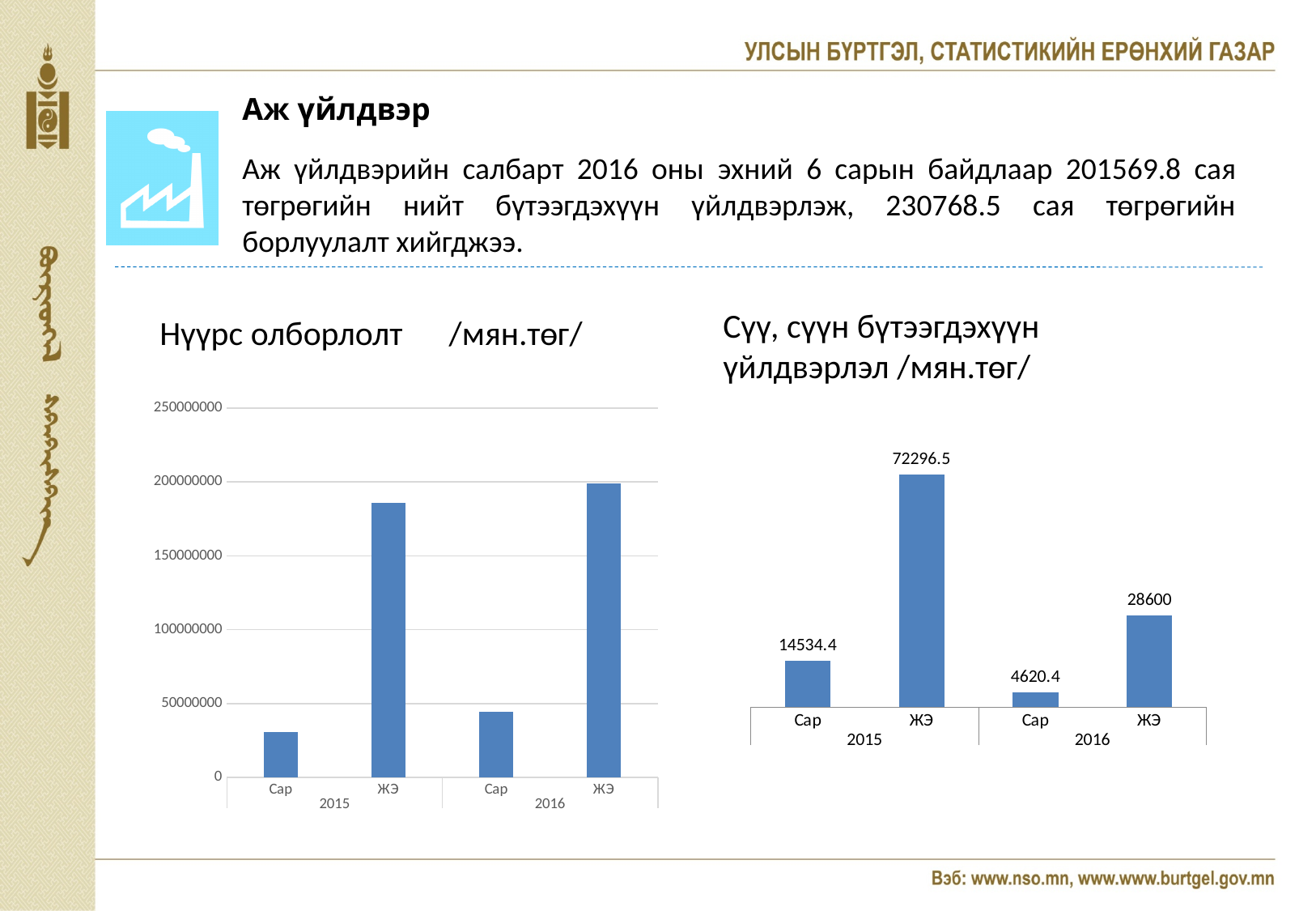
In the chart titled 'Сүү, сүүн бүтээгдэхүүн үйлдвэрлэл /мян.төг/', what is the difference between the ЖЭ values for 2015 and 2016? 43696.5 In the chart titled 'Сүү, сүүн бүтээгдэхүүн үйлдвэрлэл /мян.төг/', which is larger: Сар 2015 or Сар 2016? Сар 2015 In the chart titled 'Сүү, сүүн бүтээгдэхүүн үйлдвэрлэл /мян.төг/', what is the value for ЖЭ in 2016? 28600 In the chart titled 'Сүү, сүүн бүтээгдэхүүн үйлдвэрлэл /мян.төг/', what is the value for Сар in 2016? 4620.4 In the chart titled 'Сүү, сүүн бүтээгдэхүүн үйлдвэрлэл /мян.төг/', what is the value for ЖЭ in 2015? 72296.5 What type of chart is the chart titled 'Нүүрс олборлолт /мян.төг/'? Bar chart In the chart titled 'Нүүрс олборлолт /мян.төг/', is the value for ЖЭ in 2016 greater or less than 150000000? greater In the chart titled 'Нүүрс олборлолт /мян.төг/', which bar has the highest value? ЖЭ 2016 In the chart titled 'Сүү, сүүн бүтээгдэхүүн үйлдвэрлэл /мян.төг/', which bar has the lowest value? Сар 2016 In the chart titled 'Сүү, сүүн бүтээгдэхүүн үйлдвэрлэл /мян.төг/', which bar has the highest value? ЖЭ 2015 In the chart titled 'Нүүрс олборлолт /мян.төг/', is the value for Сар in 2015 greater or less than 50000000? less How many bars are plotted in the chart titled 'Нүүрс олборлолт /мян.төг/'? 4